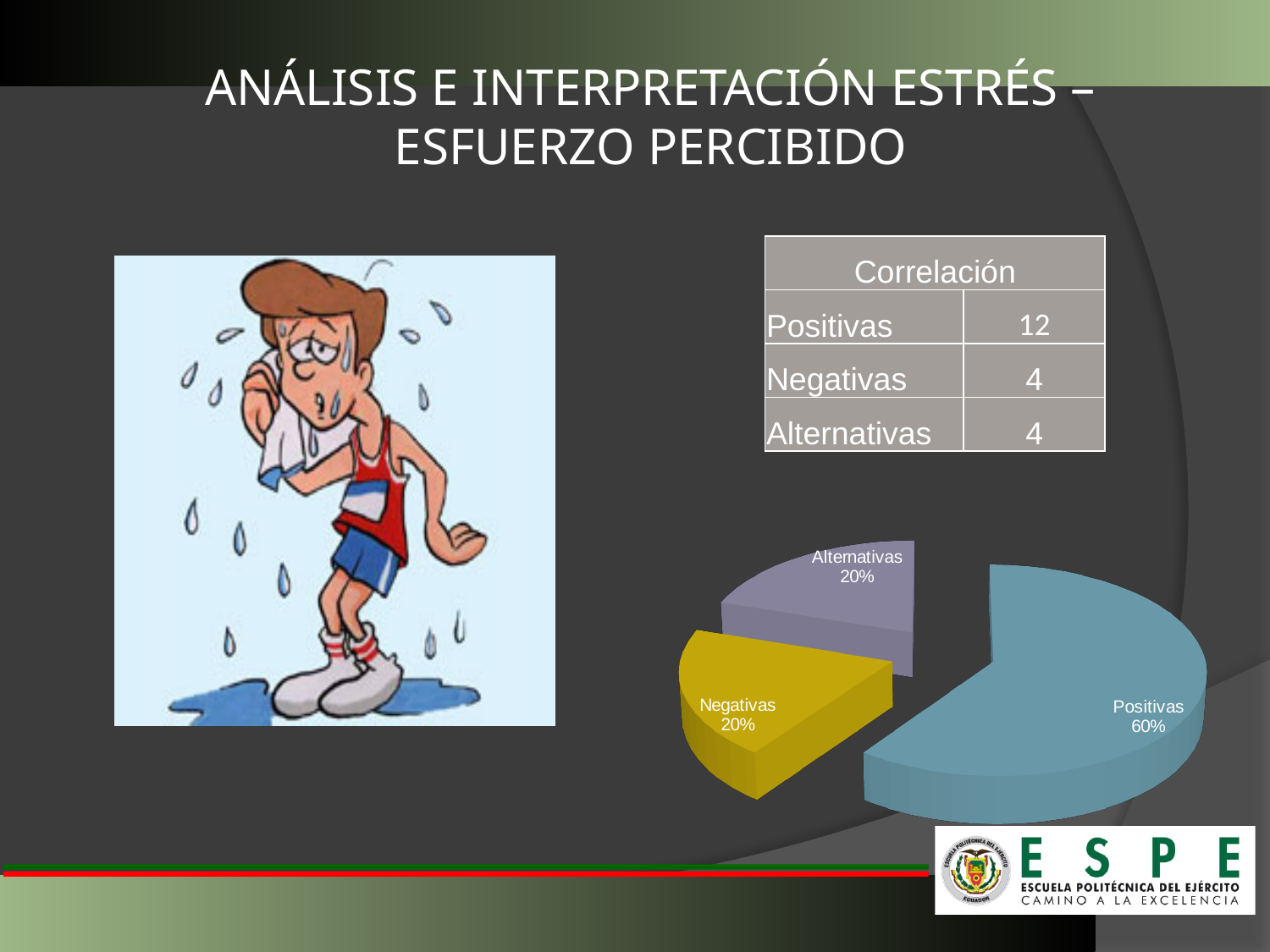
What kind of chart is shown on the slide? pie chart What colour is the Positivas slice in the pie chart? blue Is the share for Positivas in the pie chart greater or less than 50%? greater Which is larger in the pie chart, Positivas or Negativas? Positivas What colour is the Negativas slice in the pie chart? yellow What is the difference in percentage points between the Positivas slice and the Alternativas slice? 40 What share of the pie chart is labelled Negativas? 20% What share of the pie chart is labelled Positivas? 60% What share of the pie chart is labelled Alternativas? 20% How many slices does the pie chart have? 3 Which slice of the pie chart is the largest? Positivas Do the Negativas and Alternativas slices of the pie chart have the same share? Yes